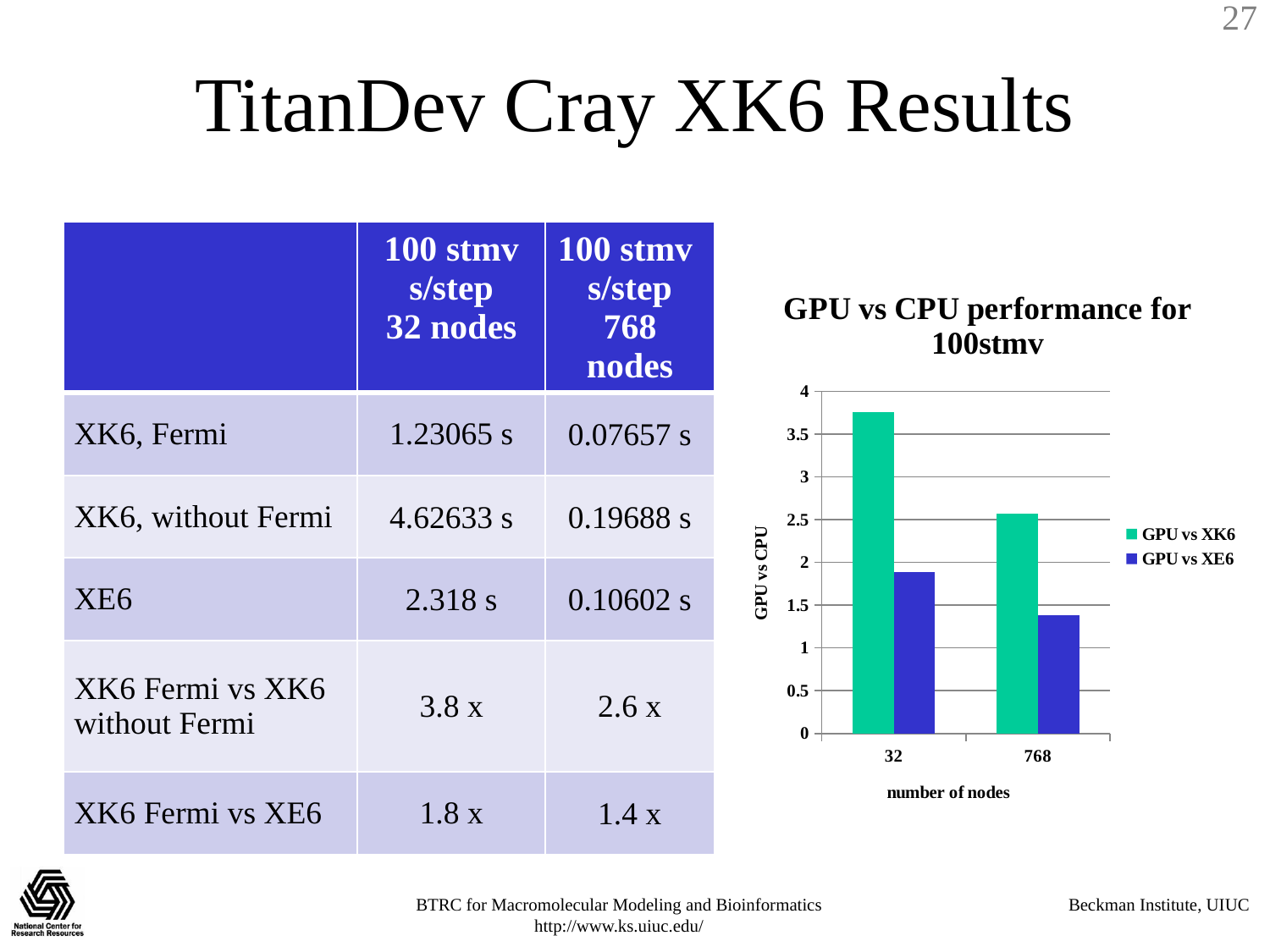
Is the GPU vs XE6 value at 32 nodes greater or less than 2? less Is the GPU vs XE6 value at 768 nodes greater or less than 1? greater Is the GPU vs XK6 value at 768 nodes greater or less than 3? less What kind of chart is shown on the slide? bar chart What is the title of the chart? GPU vs CPU performance for 100stmv Which series has the higher value at 768 nodes, GPU vs XK6 or GPU vs XE6? GPU vs XK6 Does the GPU vs XK6 series rise or fall from 32 nodes to 768 nodes? fall What is the label of the x axis of the chart? number of nodes Which bar in the chart is the tallest? GPU vs XK6 at 32 nodes How many series does the chart legend list? 2 How many node-count categories are shown on the x axis of the chart? 2